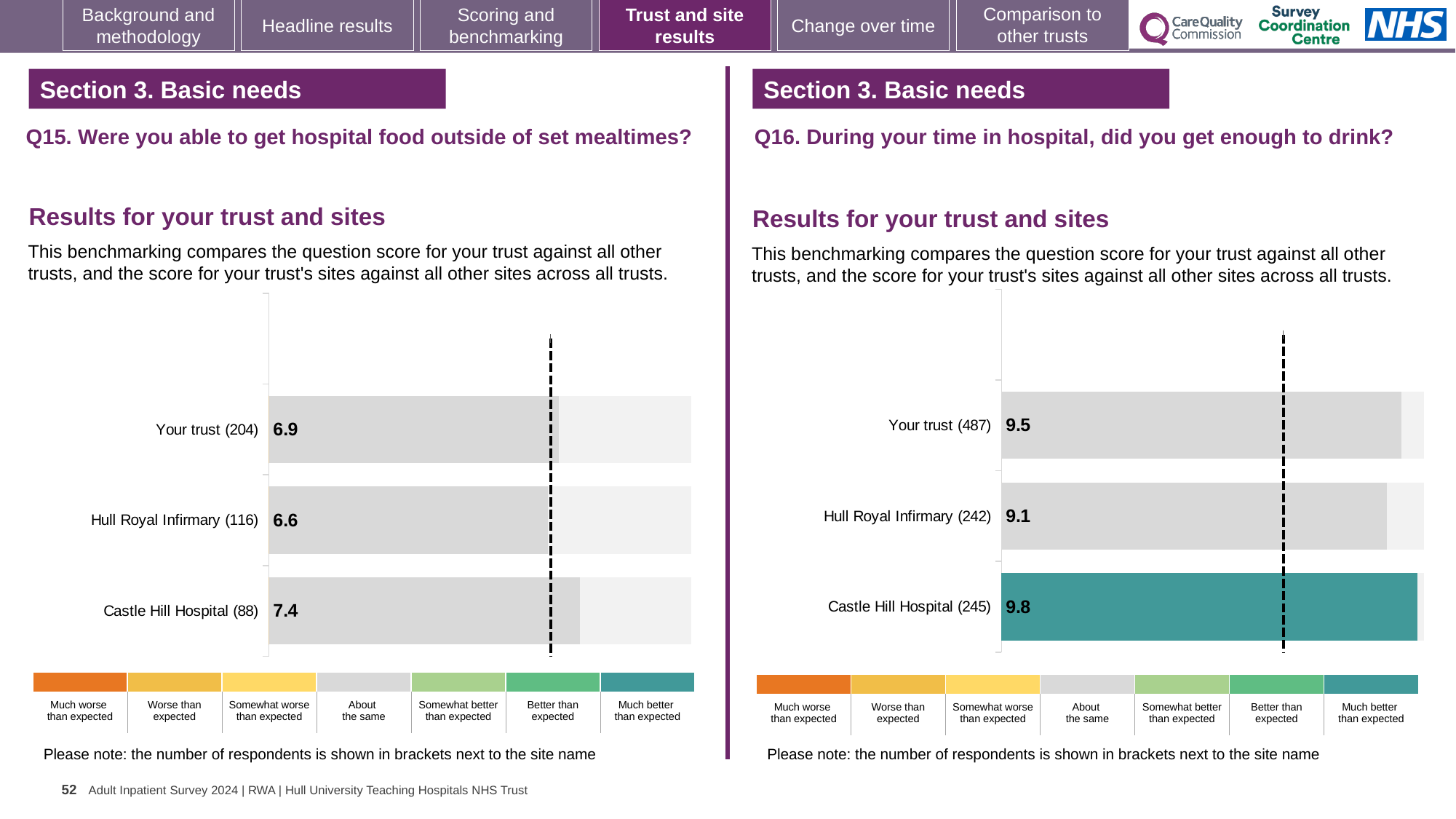
What kind of chart is used for Q15 on the left? Bar chart In the Q15 chart on the left, which site or trust has the highest score? Castle Hill Hospital In the Q16 chart on the right, which is larger, the score for Your trust or the score for Hull Royal Infirmary? Your trust In the Q16 chart on the right, which site or trust has the lowest score? Hull Royal Infirmary In the Q16 chart on the right, what is the score for Your trust? 9.5 In the Q15 chart on the left, how many bars are plotted? 3 In the Q16 chart on the right, what is the score for Castle Hill Hospital? 9.8 In the Q16 chart on the right, which benchmark category does the colour of the Castle Hill Hospital bar indicate? Much better than expected In the Q15 chart on the left, what is the score for Hull Royal Infirmary? 6.6 In the Q15 chart on the left, what is the difference between the scores for Castle Hill Hospital and Hull Royal Infirmary? 0.8 In the Q15 chart on the left, what is the score for Your trust? 6.9 In the Q16 chart on the right, what is the difference between the scores for Castle Hill Hospital and Your trust? 0.3